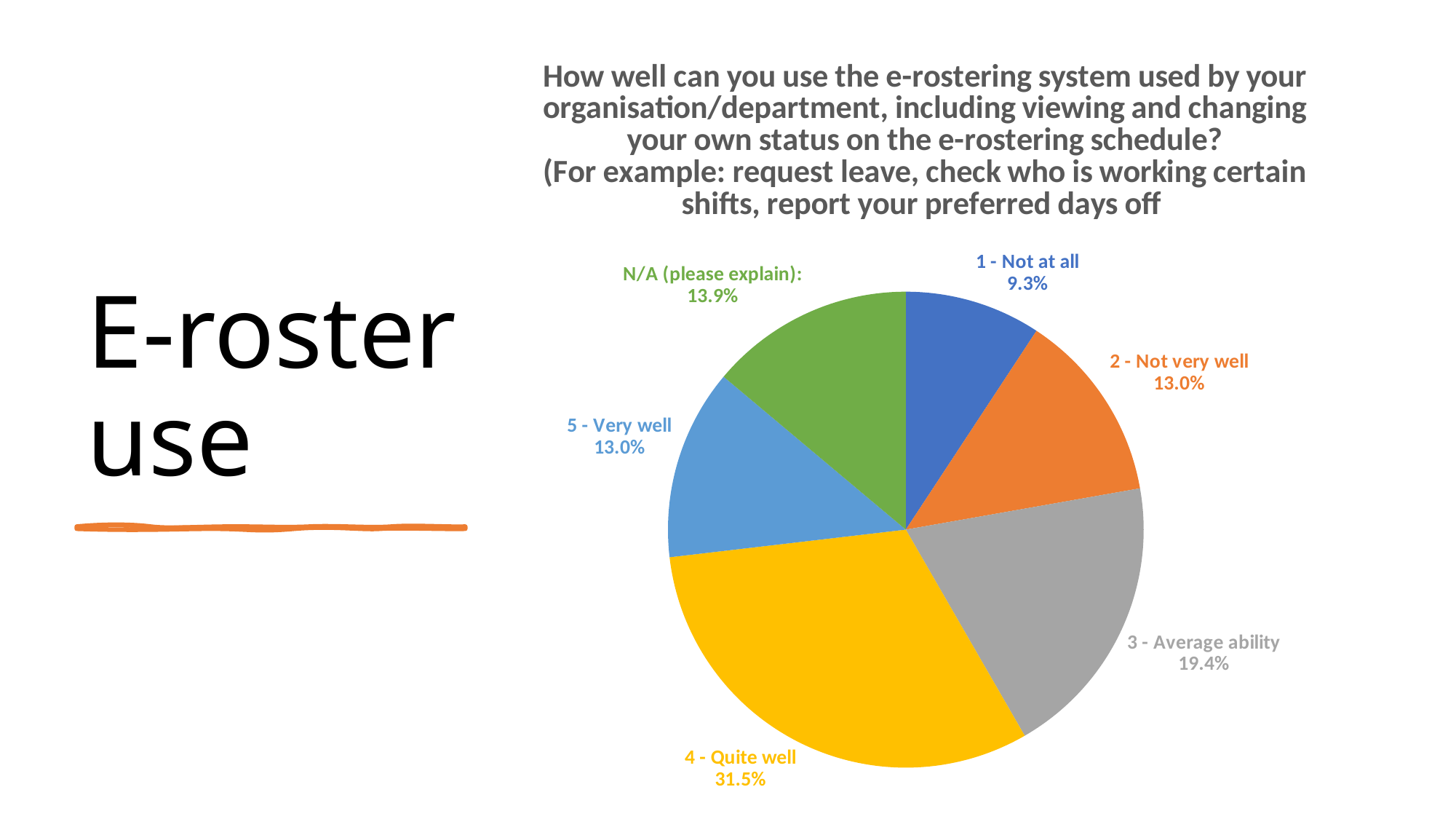
Which category has the smallest slice of the pie? 1 - Not at all How many slices does the pie chart have? 6 What percentage is shown for '3 - Average ability'? 19.4% What percentage is shown for 'N/A (please explain):'? 13.9% What is the difference in percentage points between '4 - Quite well' and '3 - Average ability'? 12.1 What is the difference in percentage points between 'N/A (please explain):' and '2 - Not very well'? 0.9 Which is larger, the slice for '3 - Average ability' or the slice for '5 - Very well'? 3 - Average ability Which category has the largest slice of the pie? 4 - Quite well What kind of chart is shown on the slide? Pie chart What colour is the slice for '4 - Quite well'? Yellow What share of the pie does '4 - Quite well' represent? 31.5% What is the value shown for '1 - Not at all'? 9.3%